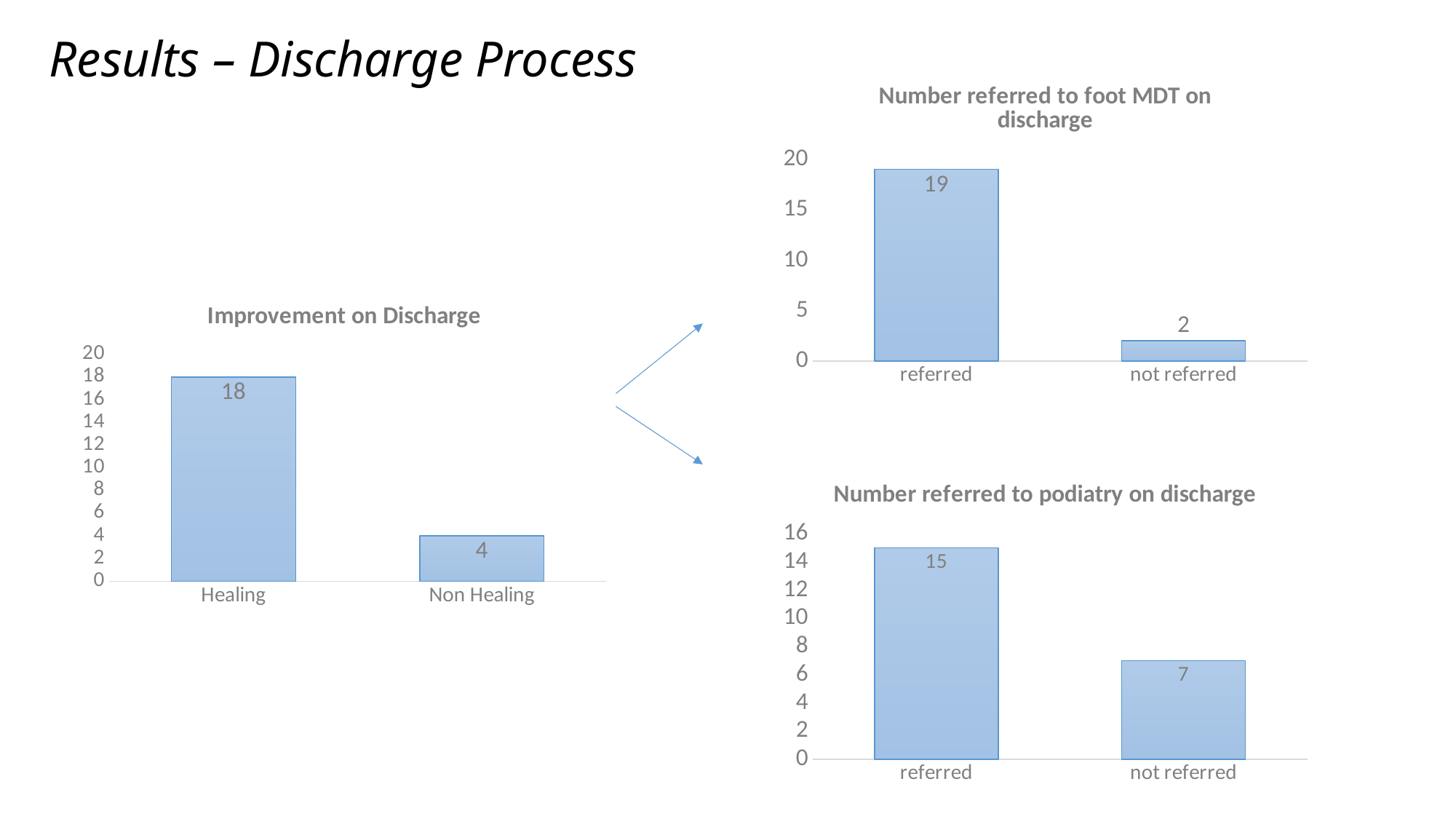
In the 'Improvement on Discharge' chart, what is the value for Non Healing? 4 In the 'Number referred to foot MDT on discharge' chart, what is the value for referred? 19 In the 'Number referred to foot MDT on discharge' chart, what is the value for not referred? 2 In the 'Number referred to podiatry on discharge' chart, what is the value for not referred? 7 In the 'Number referred to podiatry on discharge' chart, what is the difference between referred and not referred? 8 What kind of chart is the 'Number referred to foot MDT on discharge' chart? bar chart In the 'Number referred to foot MDT on discharge' chart, which category is lowest? not referred In the 'Number referred to podiatry on discharge' chart, which is larger, referred or not referred? referred How many categories are shown in the 'Improvement on Discharge' chart? 2 In the 'Improvement on Discharge' chart, what is the value for Healing? 18 In the 'Improvement on Discharge' chart, what is the difference between the Healing and Non Healing values? 14 In the 'Number referred to podiatry on discharge' chart, what is the value for referred? 15